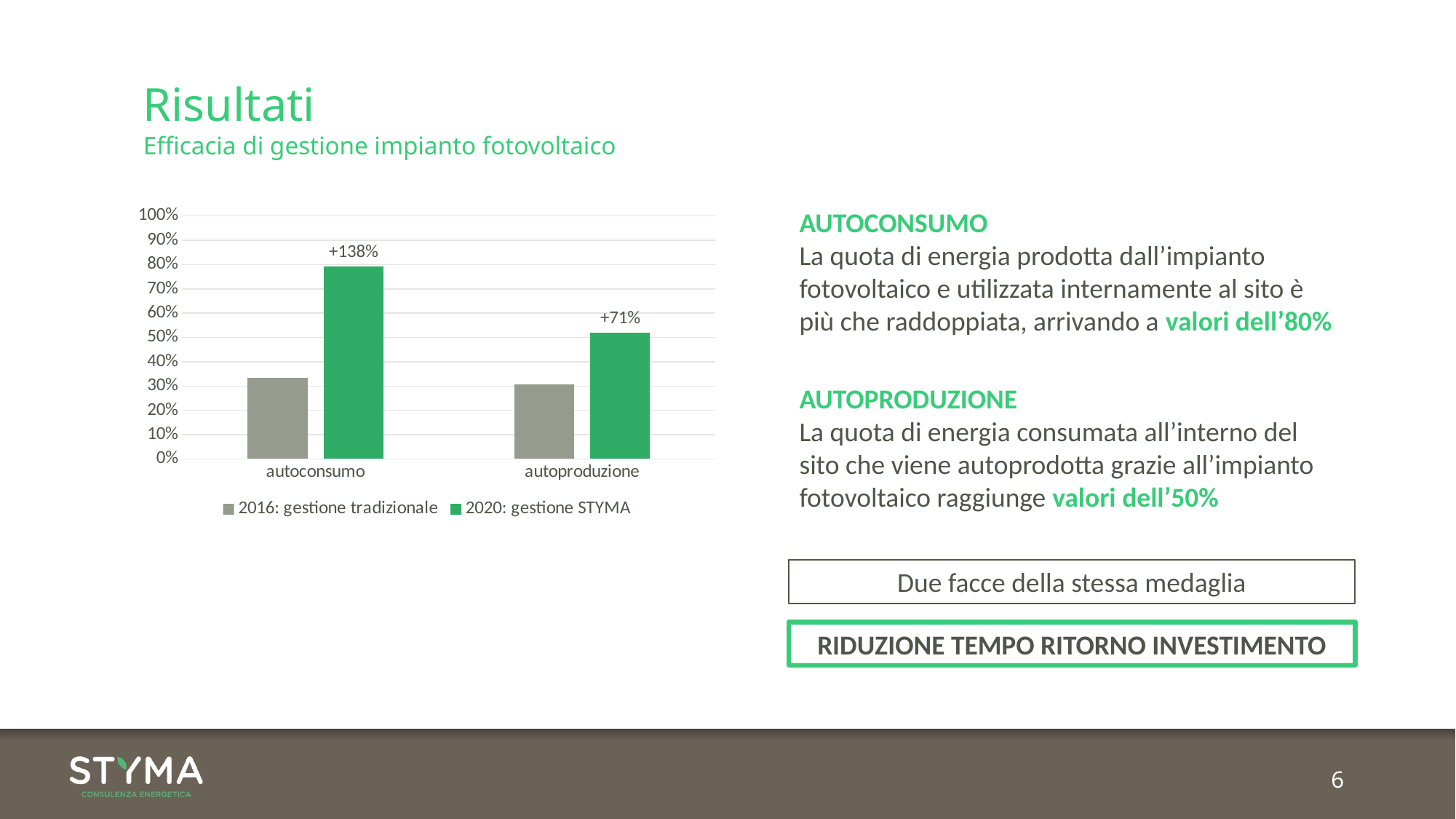
For autoproduzione, which series has the larger value: 2016: gestione tradizionale or 2020: gestione STYMA? 2020: gestione STYMA Is the 2016: gestione tradizionale value for autoconsumo greater or less than 40%? less Which bar is the tallest in the chart? 2020: gestione STYMA for autoconsumo Is the 2020: gestione STYMA value for autoconsumo greater or less than 70%? greater What percentage change label is printed above the 2020: gestione STYMA bar for autoconsumo? +138% What kind of chart is shown on the slide? bar chart Is the 2020: gestione STYMA value for autoproduzione greater or less than 60%? less Which colour represents the 2020: gestione STYMA series in the chart? green What are the two series listed in the chart legend? 2016: gestione tradizionale; 2020: gestione STYMA How many series does the chart legend list? 2 What percentage change label is printed above the 2020: gestione STYMA bar for autoproduzione? +71% How many categories are shown on the x axis of the chart? 2